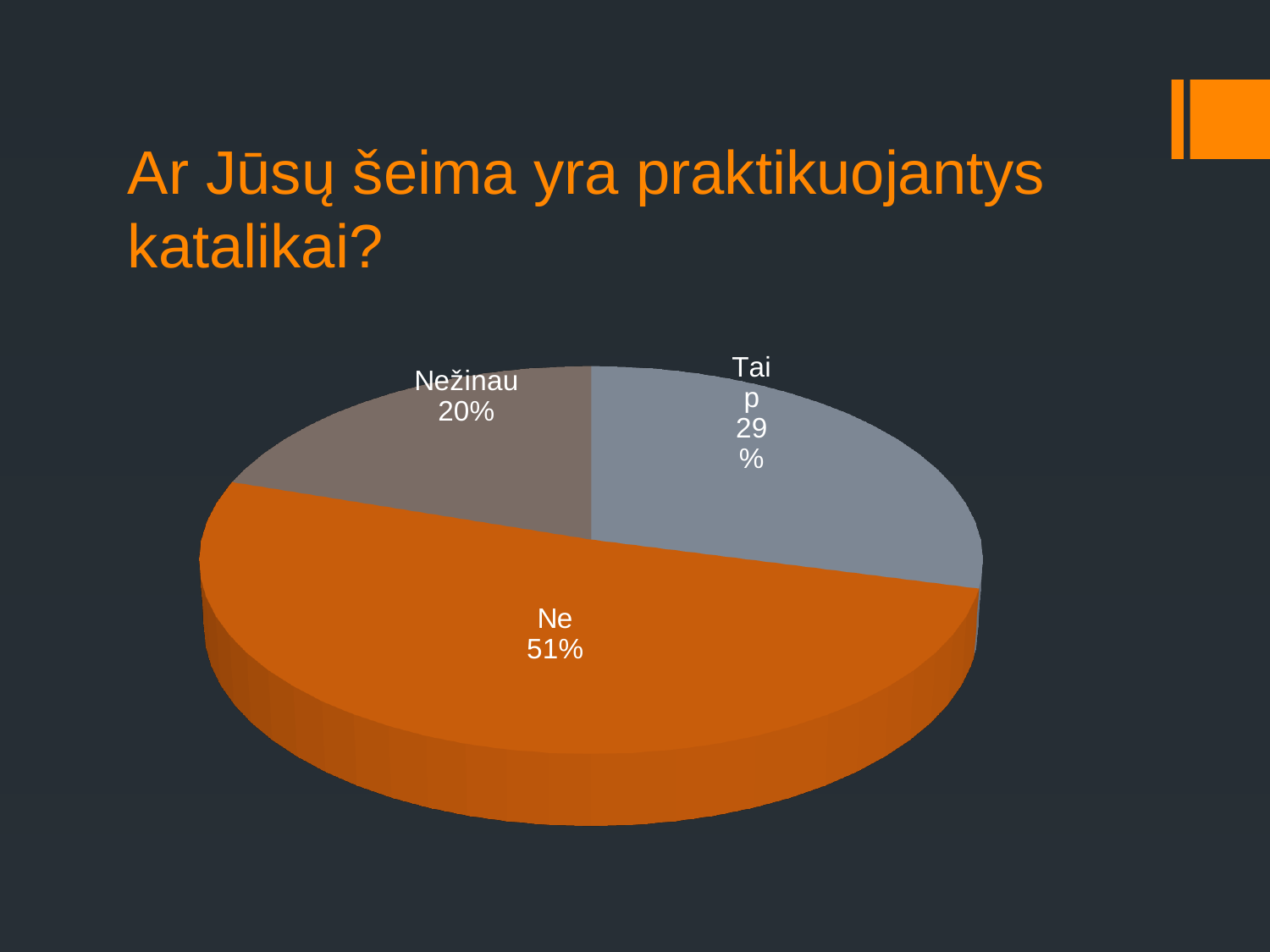
What is the title of the slide containing the chart? Ar Jūsų šeima yra praktikuojantys katalikai? How many slices does the pie chart have? 3 What colour is the "Ne" slice of the pie? Orange Which category has the largest slice of the pie? Ne What is the difference in percentage points between the "Taip" and "Nežinau" slices? 9 What share of the pie does the "Taip" slice represent? 29% What kind of chart is shown on the slide? Pie chart Which slice is larger, "Taip" or "Nežinau"? Taip What is the difference in percentage points between the "Ne" and "Taip" slices? 22 Which category has the smallest slice of the pie? Nežinau What share of the pie does the "Nežinau" slice represent? 20% What share of the pie does the "Ne" slice represent? 51%